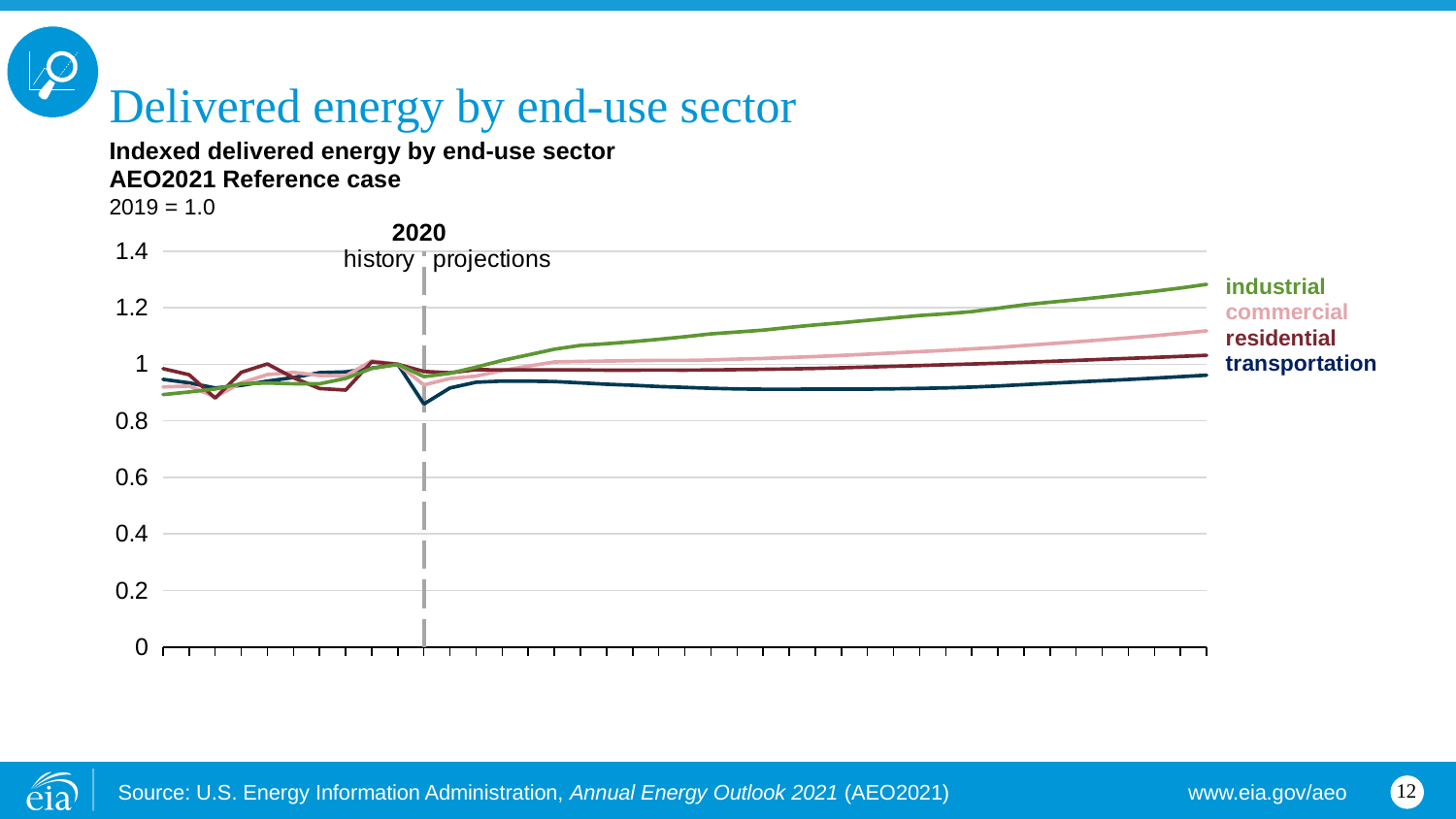
Is the value for commercial at the end of the projection period greater or less than 1? greater Is the value for industrial at the end of the projection period greater or less than 1.2? greater How many series does the chart show? 4 What kind of chart is shown on the slide? line chart What year does the dashed vertical line separating history from projections mark? 2020 Which sector has the lowest indexed delivered energy at the end of the projection period? transportation Which sector has the highest indexed delivered energy at the end of the projection period? industrial Does the industrial line rise or fall over the projection period? rise At the end of the projection period, which is larger: commercial or residential? commercial Is the value for transportation at the end of the projection period greater or less than 1? less Which year is the index base year (set equal to 1.0) for the chart? 2019